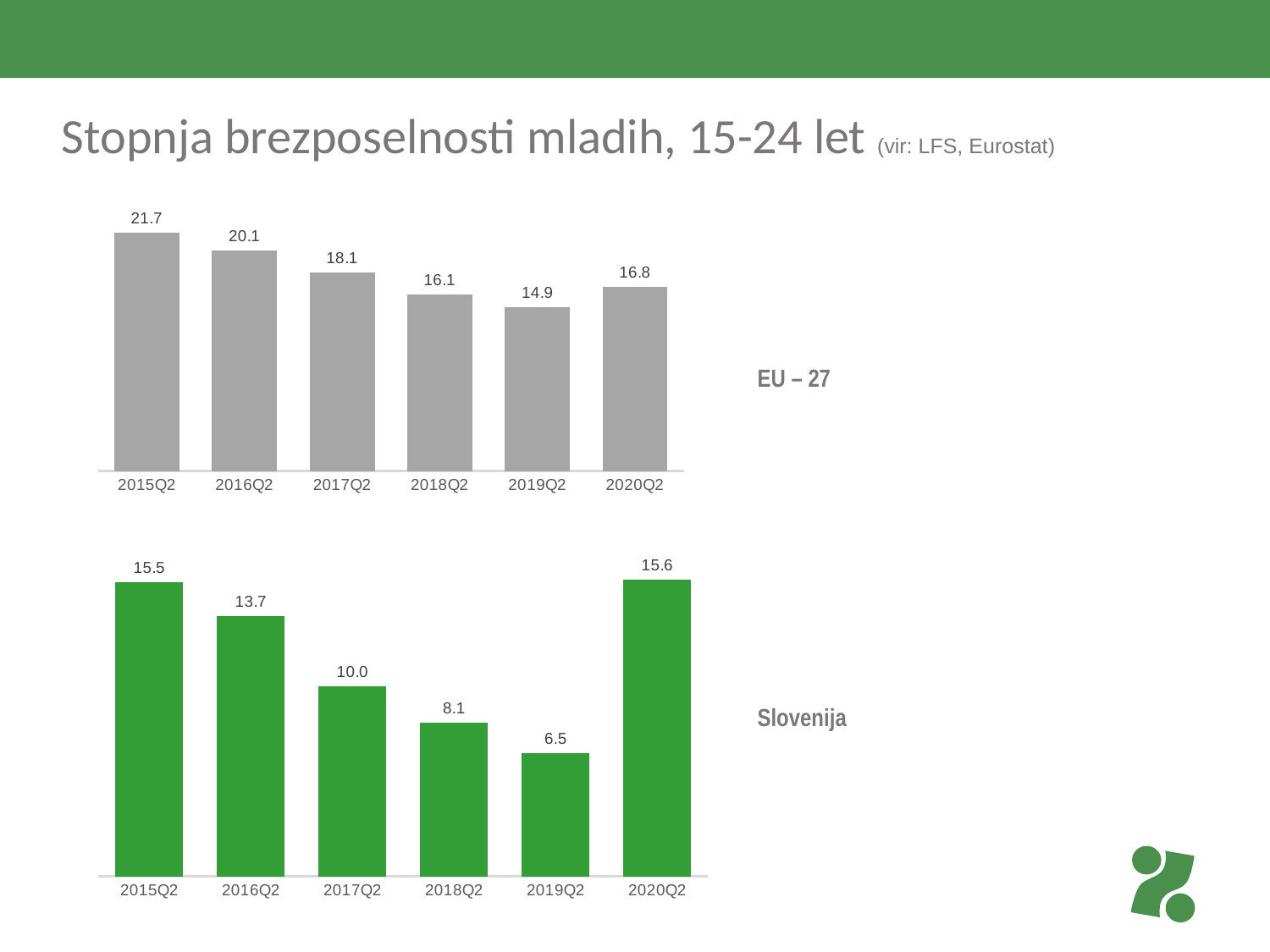
In the EU – 27 chart (top), do the values rise or fall from 2015Q2 to 2019Q2? Fall What type of chart is the EU – 27 chart (top)? Bar chart In the EU – 27 chart (top), what is the difference between the 2015Q2 and 2016Q2 values? 1.6 What colour are the bars in the Slovenija chart (bottom)? Green In the EU – 27 chart (top), what is the value for 2015Q2? 21.7 In the Slovenija chart (bottom), which quarter has the highest value? 2020Q2 How many bars are in the Slovenija chart (bottom)? 6 In the Slovenija chart (bottom), what is the value for 2019Q2? 6.5 In the EU – 27 chart (top), which is larger, the value for 2017Q2 or the value for 2020Q2? 2017Q2 In the Slovenija chart (bottom), what is the difference between the 2020Q2 and 2019Q2 values? 9.1 In the Slovenija chart (bottom), which is larger, the value for 2016Q2 or the value for 2017Q2? 2016Q2 In the EU – 27 chart (top), which quarter has the lowest value? 2019Q2